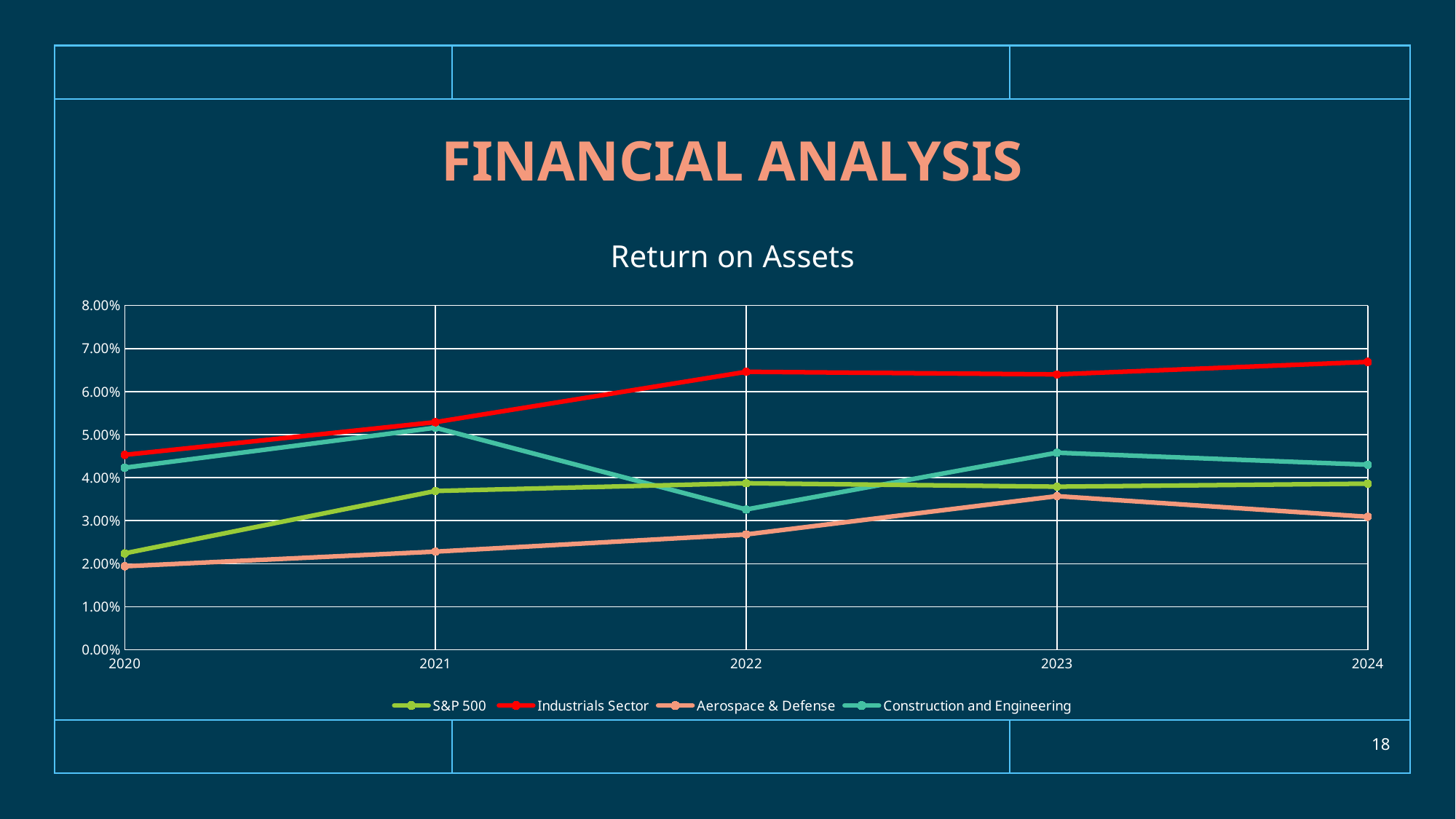
Is the value for S&P 500 in 2020 greater or less than 3.00%? less In 2022, which is larger: S&P 500 or Construction and Engineering? S&P 500 Is the value for Industrials Sector in 2022 greater or less than 6.00%? greater What kind of chart is shown on the slide? line chart What is the title of the chart? Return on Assets Which series has the lowest Return on Assets in 2022? Aerospace & Defense Which series has the highest Return on Assets in 2024? Industrials Sector How many years are plotted along the x axis? 5 In which year is the Construction and Engineering value highest? 2021 In which year is the S&P 500 value lowest? 2020 Does the Industrials Sector line rise or fall overall from 2020 to 2024? rise How many series does the legend list? 4